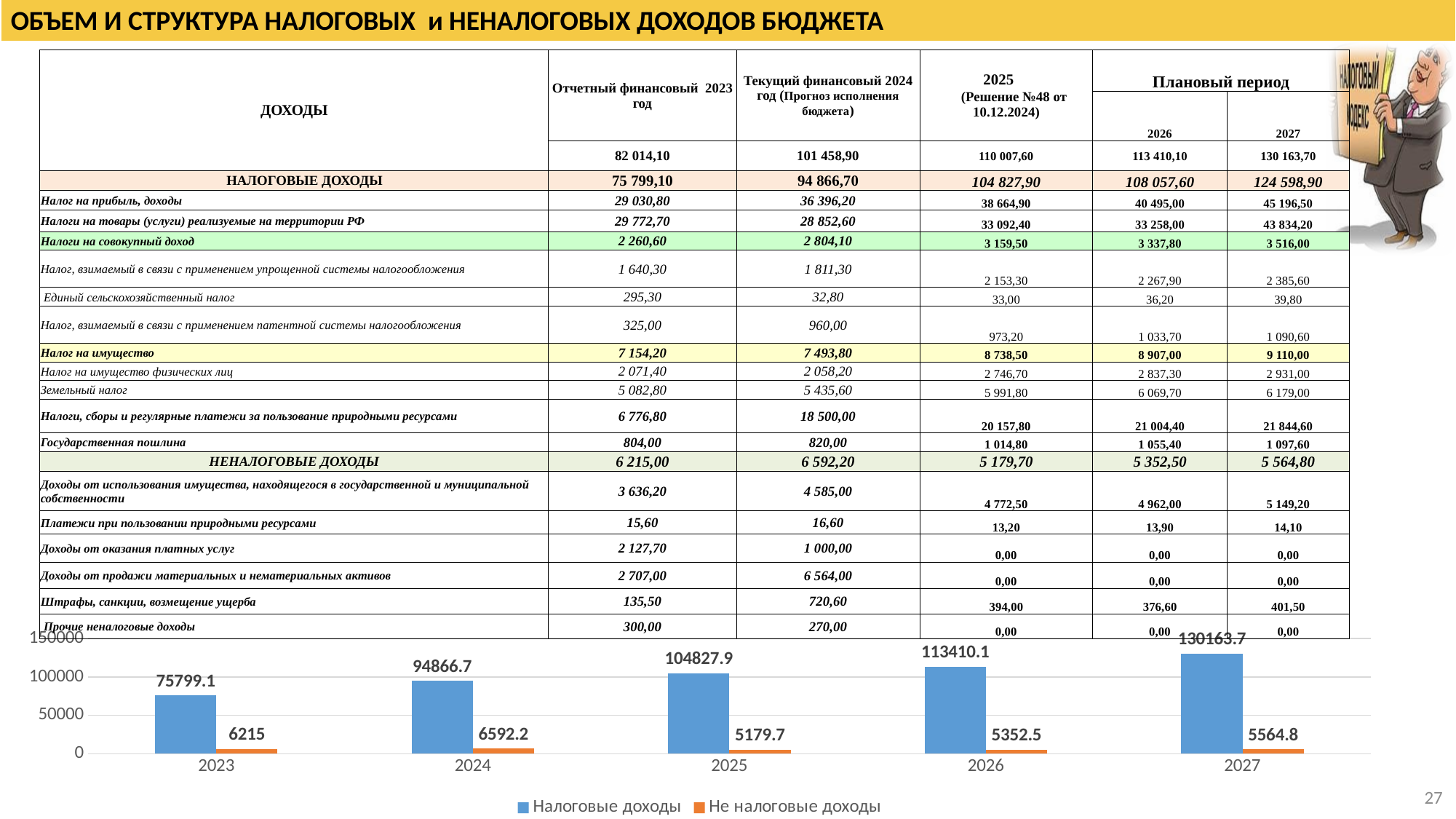
How many series does the chart legend list? 2 What is the value of Не налоговые доходы for 2025 in the chart? 5179.7 How many years are shown on the x axis of the chart? 5 What is the value of Налоговые доходы for 2027 in the chart? 130163.7 Which year has the highest value of Налоговые доходы in the chart? 2027 What is the value of Налоговые доходы for 2023 in the chart? 75799.1 What is the difference between Налоговые доходы in 2024 and 2023 in the chart? 19067.6 What type of chart is shown at the bottom of the slide? bar chart Which year has the lowest value of Не налоговые доходы in the chart? 2025 Which is larger in the chart: Не налоговые доходы in 2024 or in 2026? 2024 Do the values of Налоговые доходы rise or fall from 2023 to 2027 in the chart? rise Which colour represents Не налоговые доходы in the chart? orange